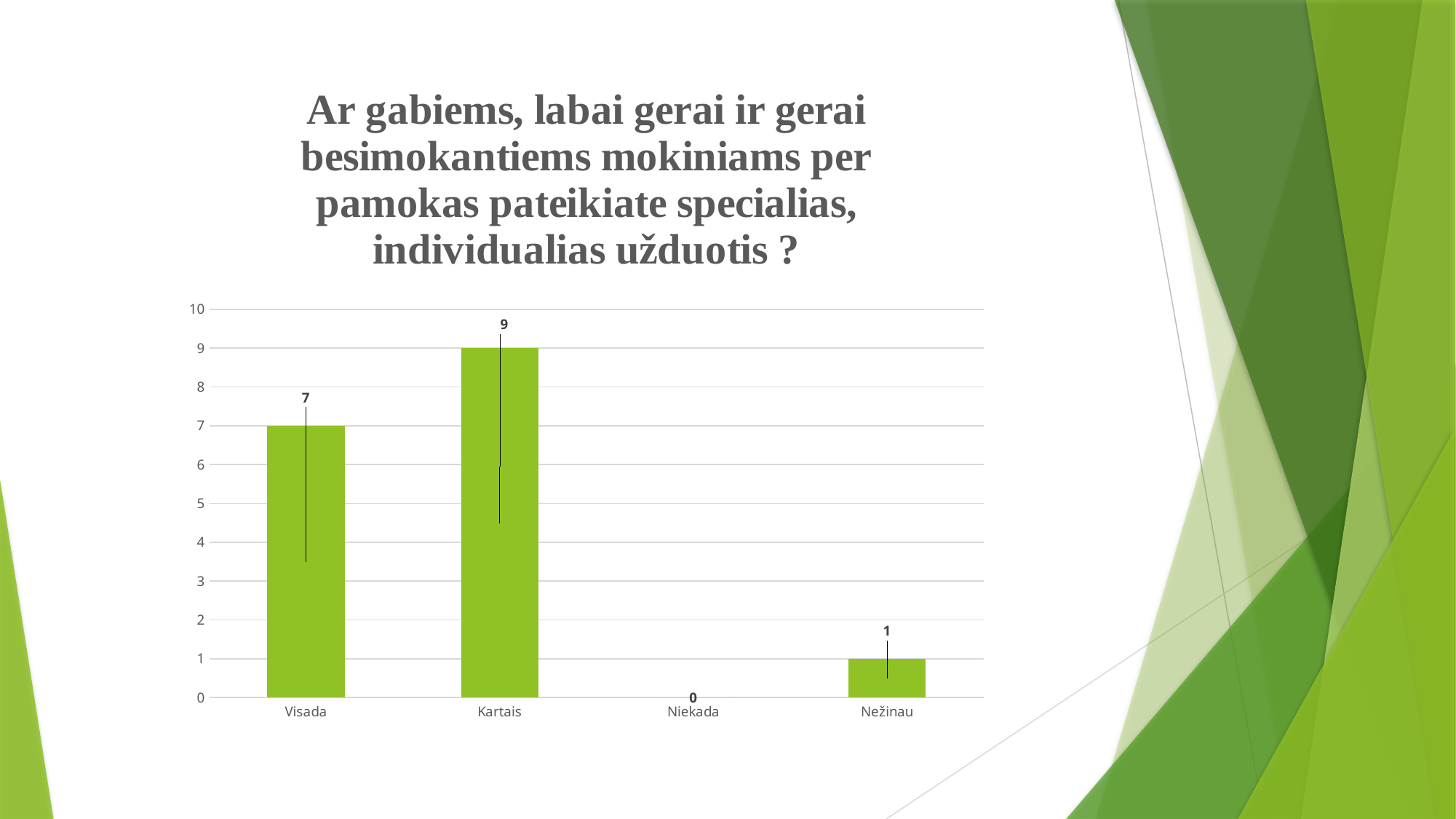
What is the value for Nežinau? 1 What is the value for Kartais? 9 What is the value for Niekada? 0 What is the value for Visada? 7 What is the difference between the values for Kartais and Visada? 2 What is the total of the values for Visada, Kartais, Niekada and Nežinau? 17 Is the value for Kartais greater or less than 5? greater How many categories are shown on the x axis? 4 What kind of chart is shown on the slide? bar chart Which category has the highest value? Kartais Which is larger, the value for Visada or the value for Nežinau? Visada Which category has the lowest value? Niekada